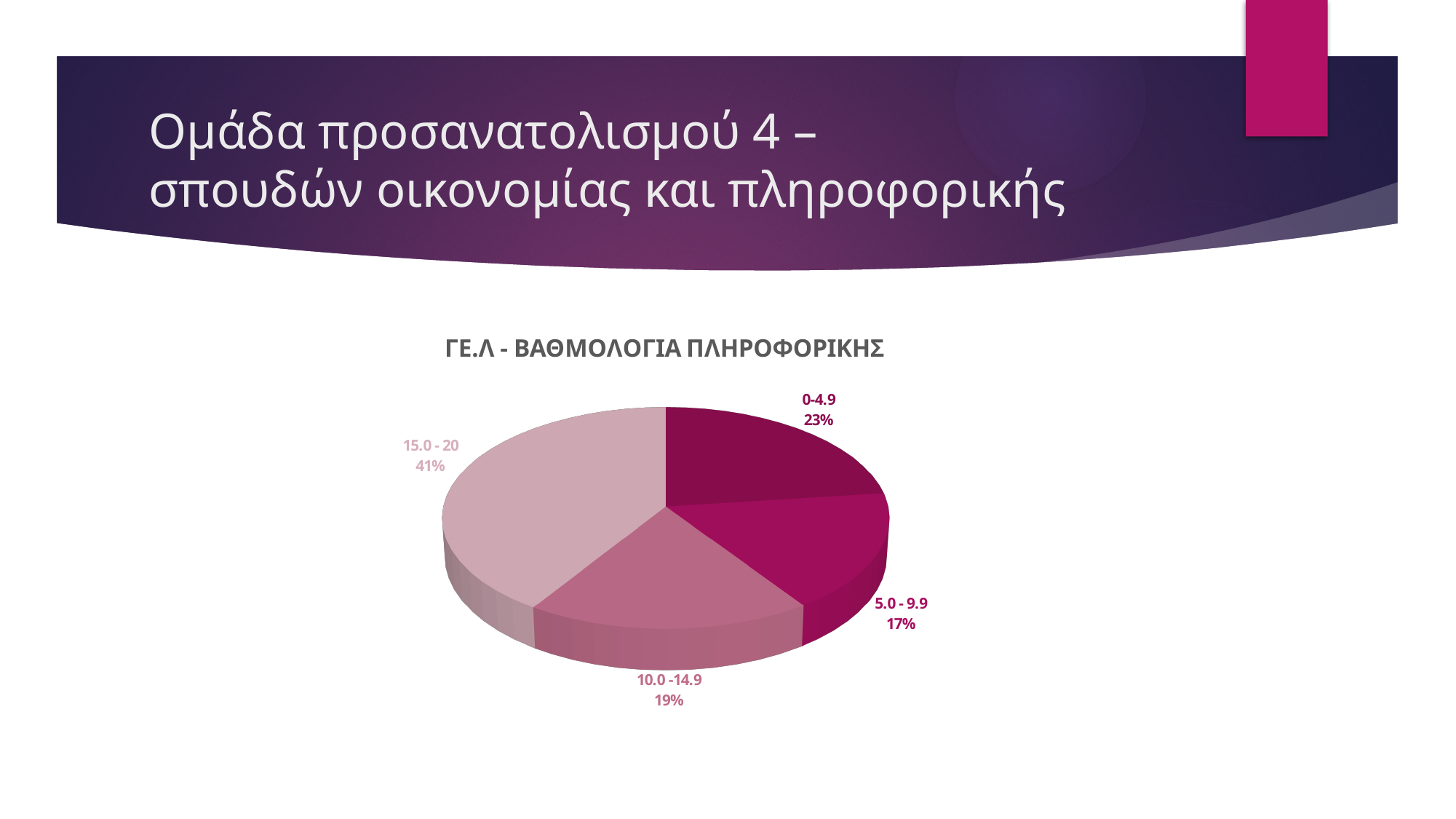
What is the difference in percentage points between the 15.0 - 20 slice and the 0-4.9 slice? 18 What is the value shown for the 5.0 - 9.9 category? 17% What is the value shown for the 10.0 -14.9 category? 19% How many categories are shown in the pie chart? 4 What kind of chart is shown on the slide? Pie chart Which category has the largest slice of the pie? 15.0 - 20 What is the combined share of the 0-4.9 and 5.0 - 9.9 slices? 40% Which category has the smallest slice of the pie? 5.0 - 9.9 Which is larger, the 0-4.9 slice or the 10.0 -14.9 slice? 0-4.9 What is the value shown for the 0-4.9 category? 23% What is the title of the chart? ΓΕ.Λ - ΒΑΘΜΟΛΟΓΙΑ ΠΛΗΡΟΦΟΡΙΚΗΣ What share of the pie does the 15.0 - 20 slice represent? 41%